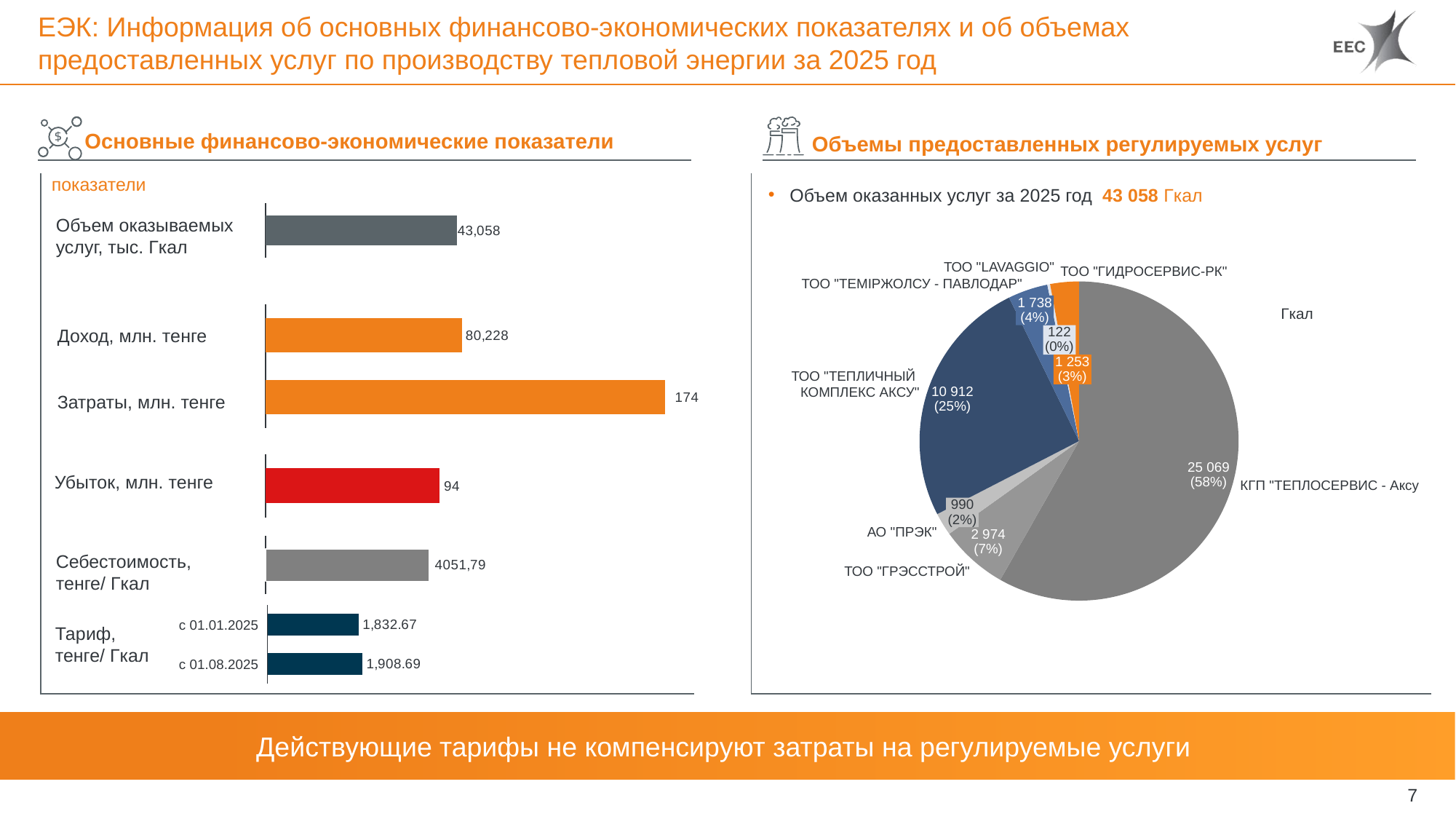
On the left bar chart, what is the value for Убыток, млн. тенге? 94 On the pie chart, what share does ТОО "ТЕПЛИЧНЫЙ КОМПЛЕКС АКСУ" have? 25% On the pie chart, what is the value for КГП "ТЕПЛОСЕРВИС - Аксу"? 25 069 On the left bar chart, what is the difference between the tariff from 01.08.2025 and the tariff from 01.01.2025? 76.02 On the left bar chart, what is the tariff (Тариф, тенге/Гкал) from 01.08.2025? 1,908.69 On the left bar chart, what is the value for Себестоимость, тенге/Гкал? 4051,79 What kind of chart is shown on the right side of the slide? Pie chart What kind of chart is shown on the left side of the slide? Bar chart On the pie chart, which company has the largest slice? КГП "ТЕПЛОСЕРВИС - Аксу" How many slices does the pie chart have? 7 On the left bar chart, what is the value for Доход, млн. тенге? 80,228 On the pie chart, which company has the smallest slice? ТОО "LAVAGGIO"